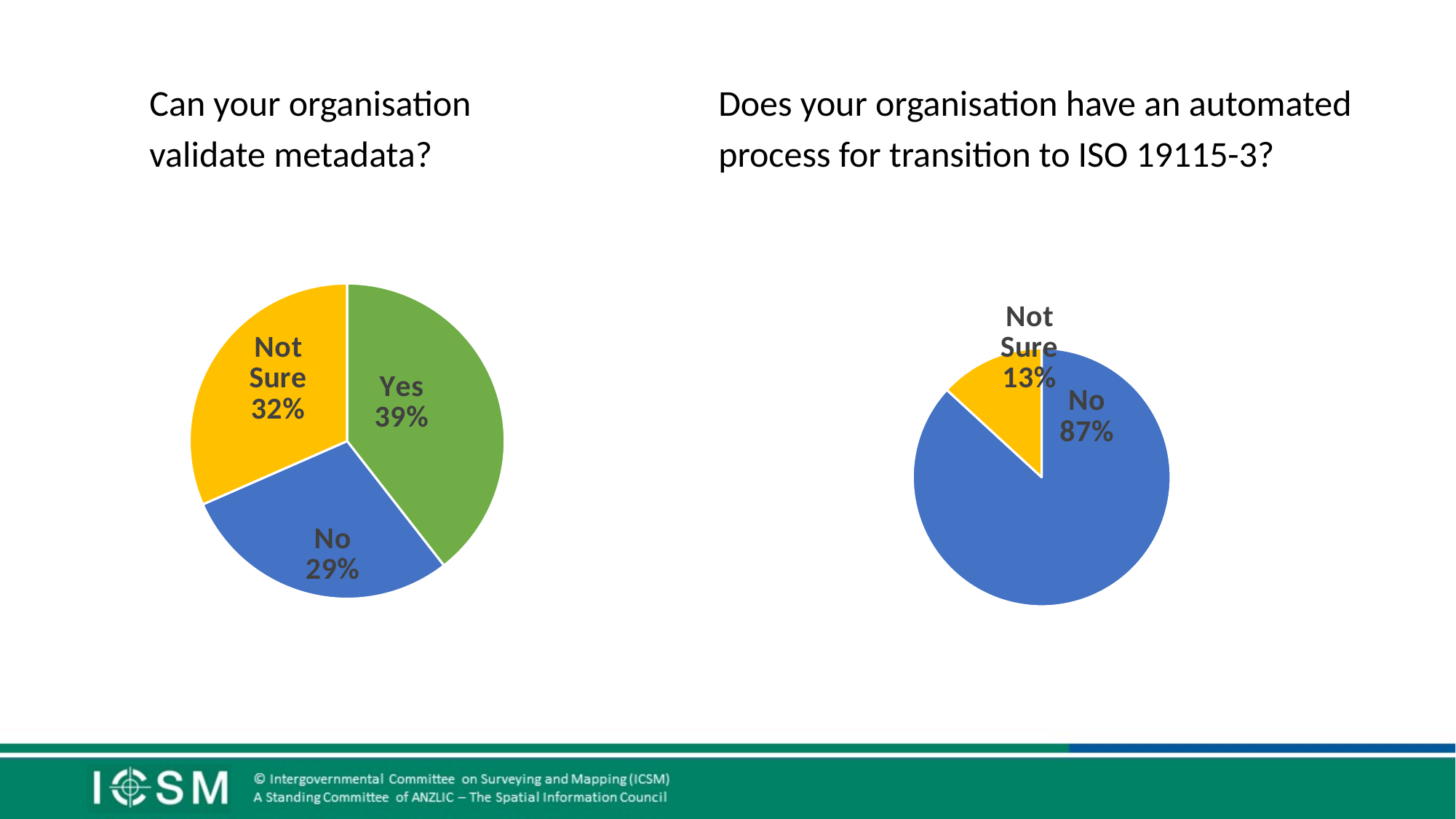
In the 'Does your organisation have an automated process for transition to ISO 19115-3?' chart, how many slices does the pie have? 2 In the 'Can your organisation validate metadata?' chart, how many slices does the pie have? 3 In the 'Can your organisation validate metadata?' chart, what is the value for 'Not Sure'? 32% What type of chart is the chart on the left of the slide? Pie chart In the 'Can your organisation validate metadata?' chart, which category has the largest share? Yes In the 'Can your organisation validate metadata?' chart, what is the difference between 'Yes' and 'No'? 10% In the 'Does your organisation have an automated process for transition to ISO 19115-3?' chart, what is the value for 'Not Sure'? 13% In the 'Does your organisation have an automated process for transition to ISO 19115-3?' chart, what is the difference between 'No' and 'Not Sure'? 74% In the 'Does your organisation have an automated process for transition to ISO 19115-3?' chart, what share of the pie is 'No'? 87% In the 'Can your organisation validate metadata?' chart, what is the value for 'No'? 29% In the 'Can your organisation validate metadata?' chart, which category has the smallest share? No In the 'Can your organisation validate metadata?' chart, what share of the pie is 'Yes'? 39%